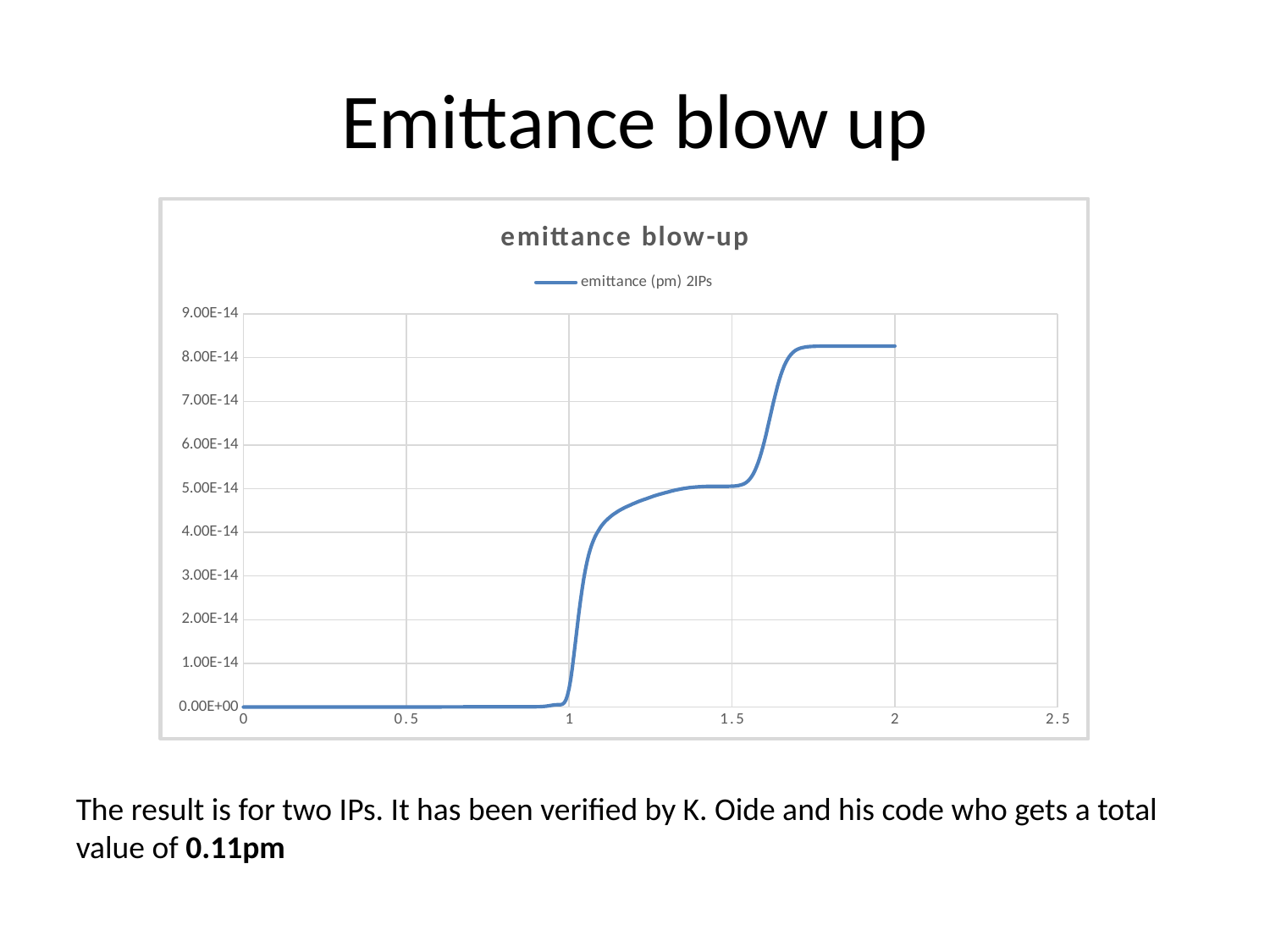
Is the emittance value at x = 2 greater or less than 9.00E-14? less Is the emittance value at x = 1.5 greater or less than 6.00E-14? less What is the name of the series shown in the chart legend? emittance (pm) 2IPs Does the emittance value generally rise or fall as the x value increases from 0 to 2? rise Is the emittance value at x = 1.75 greater or less than 7.00E-14? greater Which is larger, the emittance value at x = 0.5 or at x = 1.25? x = 1.25 How many series does the chart legend list? 1 What is the title of the chart? emittance blow-up Which is larger, the emittance value at x = 1.5 or at x = 2? x = 2 What kind of chart is shown on the slide? line chart